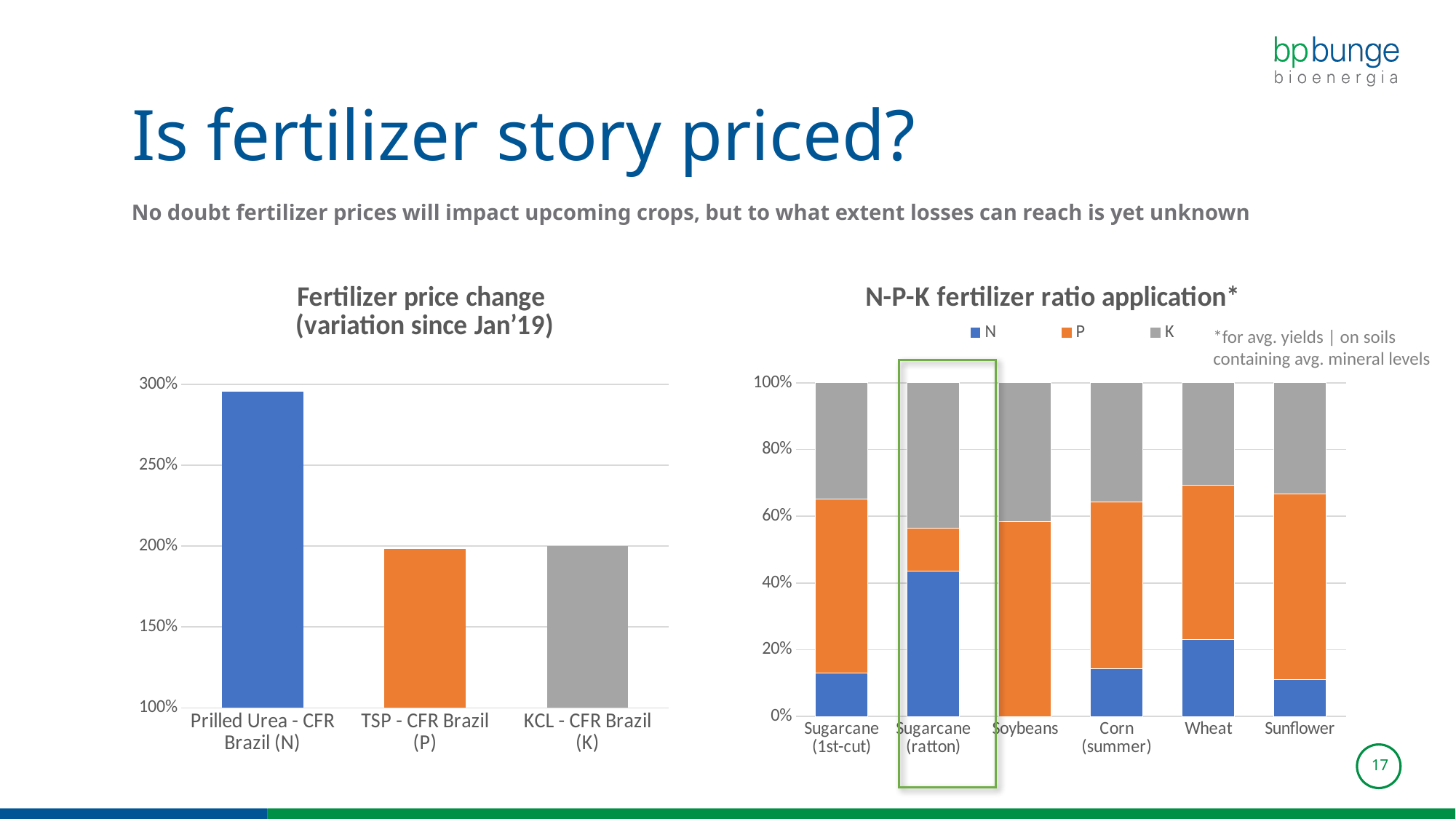
In the 'Fertilizer price change' chart, how many categories are shown? 3 In the 'Fertilizer price change' chart, which category has the highest value? Prilled Urea - CFR Brazil (N) How many series does the legend of the 'N-P-K fertilizer ratio application*' chart list? 3 What kind of chart is the 'Fertilizer price change (variation since Jan'19)' chart? bar chart In the 'N-P-K fertilizer ratio application*' chart, which colour represents the P series? orange In the 'Fertilizer price change' chart, is the value for Prilled Urea - CFR Brazil (N) greater or less than 250%? greater In the 'Fertilizer price change' chart, is the value for TSP - CFR Brazil (P) greater or less than 250%? less In the 'N-P-K fertilizer ratio application*' chart, is the N share for Sugarcane (ratton) greater or less than 40%? greater How many crop categories are shown in the 'N-P-K fertilizer ratio application*' chart? 6 In the 'Fertilizer price change' chart, which is larger: the value for Prilled Urea - CFR Brazil (N) or TSP - CFR Brazil (P)? Prilled Urea - CFR Brazil (N) In the 'N-P-K fertilizer ratio application*' chart, which crop has the largest N share? Sugarcane (ratton)